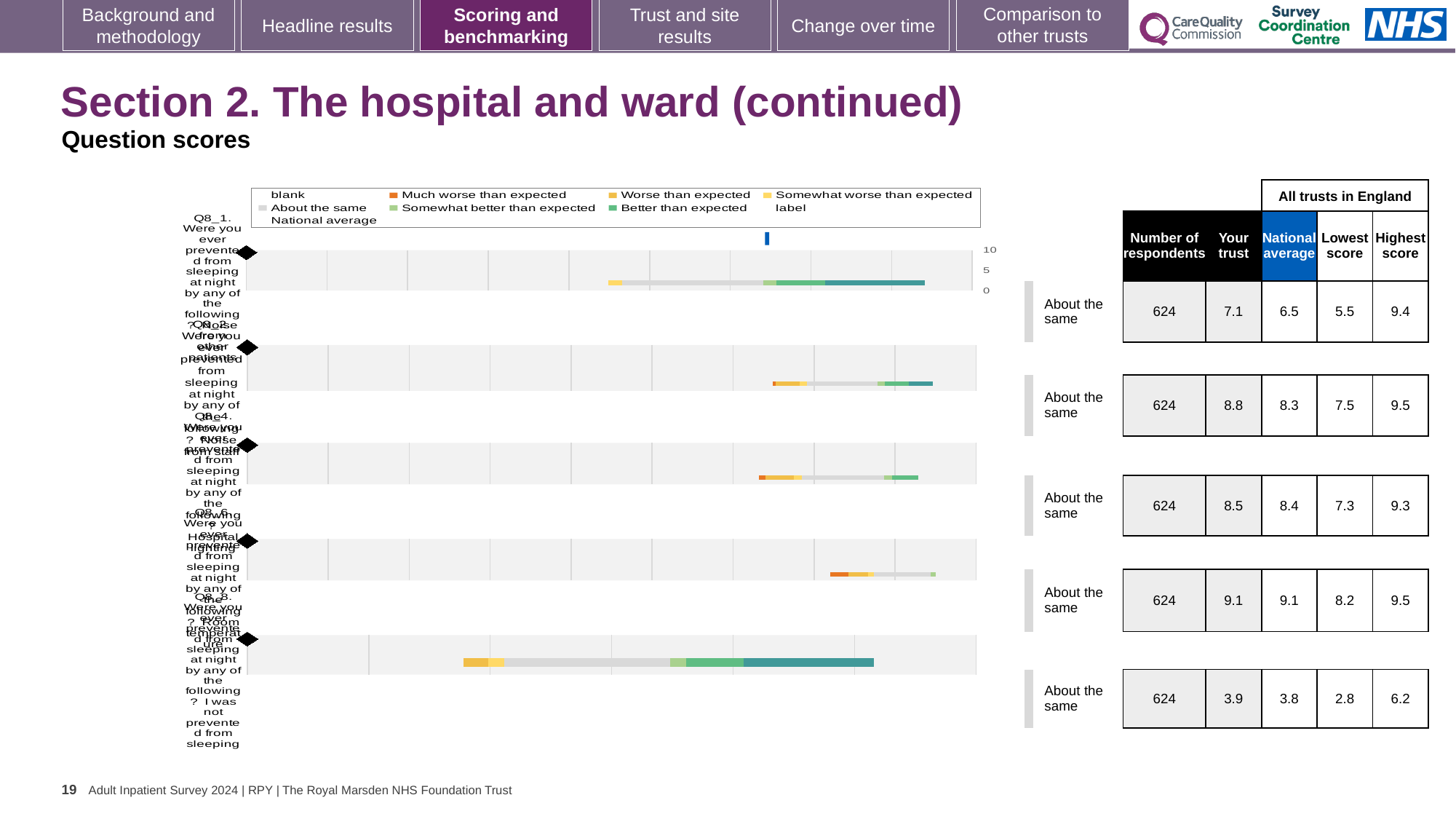
How many question bars are plotted in the chart? 5 What benchmark label is shown next to each of the five question bars? About the same What is the maximum value shown on the chart's score axis? 10 In the table beside the chart, what is the national average for the last (bottom) question, Q8_8? 3.8 Which legend entry is shown in grey in the chart? About the same For the first (top) question, Q8_1, which is larger: the 'Your trust' score or the national average? Your trust Which question row has the highest 'Your trust' score in the table beside the chart? Q8_6 (fourth row), 9.1 What kind of chart is shown on the slide? bar chart In the table beside the chart, what is the 'Your trust' score for the first (top) question, Q8_1? 7.1 For the second question, Q8_2, what is the difference between the highest score (9.5) and the lowest score (7.5) in the table? 2.0 How many respondents are listed for each question in the table beside the chart? 624 Which question row has the lowest 'Your trust' score in the table beside the chart? Q8_8 (bottom row), 3.9